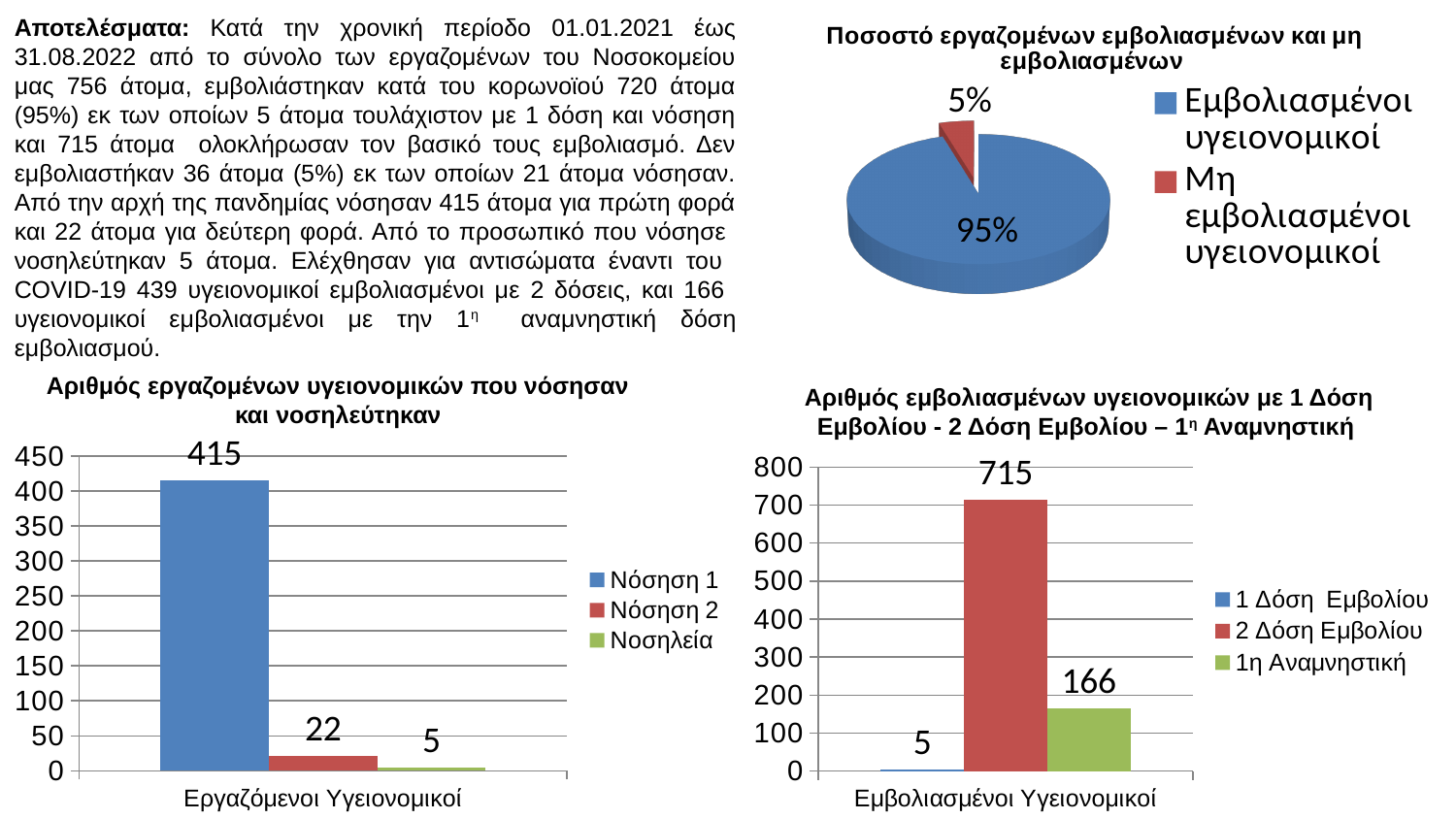
In the bottom-right chart 'Αριθμός εμβολιασμένων υγειονομικών με 1 Δόση Εμβολίου - 2 Δόση Εμβολίου – 1η Αναμνηστική', which series has the highest value? 2 Δόση Εμβολίου How many series does the legend of the bottom-left chart 'Αριθμός εργαζομένων υγειονομικών που νόσησαν και νοσηλεύτηκαν' list? 3 In the bottom-left chart 'Αριθμός εργαζομένων υγειονομικών που νόσησαν και νοσηλεύτηκαν', what is the difference between 'Νόσηση 1' and 'Νόσηση 2'? 393 In the bottom-left chart 'Αριθμός εργαζομένων υγειονομικών που νόσησαν και νοσηλεύτηκαν', what is the value for 'Νόσηση 1'? 415 In the pie chart 'Ποσοστό εργαζομένων εμβολιασμένων και μη εμβολιασμένων', what share is shown for 'Μη εμβολιασμένοι υγειονομικοί'? 5% What kind of chart is the bottom-right chart 'Αριθμός εμβολιασμένων υγειονομικών με 1 Δόση Εμβολίου - 2 Δόση Εμβολίου – 1η Αναμνηστική'? bar chart In the bottom-left chart 'Αριθμός εργαζομένων υγειονομικών που νόσησαν και νοσηλεύτηκαν', what is the value for 'Νόσηση 2'? 22 In the bottom-right chart 'Αριθμός εμβολιασμένων υγειονομικών με 1 Δόση Εμβολίου - 2 Δόση Εμβολίου – 1η Αναμνηστική', what is the value for '1η Αναμνηστική'? 166 In the bottom-right chart 'Αριθμός εμβολιασμένων υγειονομικών με 1 Δόση Εμβολίου - 2 Δόση Εμβολίου – 1η Αναμνηστική', what is the value for '2 Δόση Εμβολίου'? 715 In the pie chart 'Ποσοστό εργαζομένων εμβολιασμένων και μη εμβολιασμένων', what share is shown for 'Εμβολιασμένοι υγειονομικοί'? 95% In the bottom-left chart 'Αριθμός εργαζομένων υγειονομικών που νόσησαν και νοσηλεύτηκαν', which series has the lowest value? Νοσηλεία What kind of chart is the top-right chart 'Ποσοστό εργαζομένων εμβολιασμένων και μη εμβολιασμένων'? pie chart